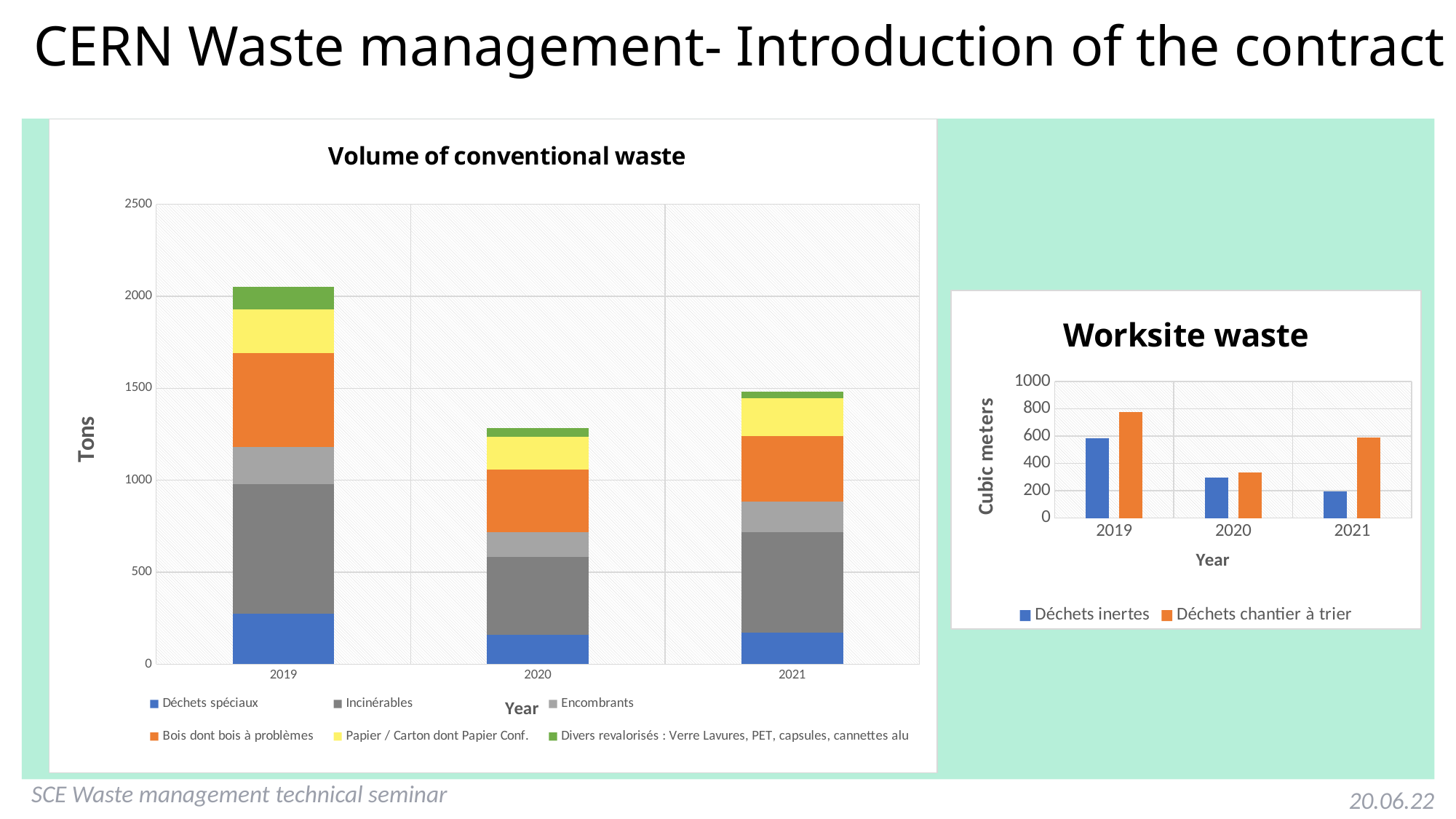
What is the y-axis label of the 'Worksite waste' chart? Cubic meters In the 'Worksite waste' chart, which year has the highest value for Déchets chantier à trier? 2019 In the 'Volume of conventional waste' chart, is the total for 2020 greater or less than 1500 tons? less How many series does the legend of the 'Volume of conventional waste' chart list? 6 In the 'Worksite waste' chart, does the value for Déchets inertes rise or fall from 2019 to 2021? fall In the 'Volume of conventional waste' chart, is the total for 2021 greater or less than 1000 tons? greater How many series does the legend of the 'Worksite waste' chart list? 2 In the 'Volume of conventional waste' chart, which year has the lowest total volume? 2020 In the 'Volume of conventional waste' chart, which series forms the largest segment of the 2019 bar? Incinérables In the 'Worksite waste' chart, is the value for Déchets chantier à trier in 2019 greater or less than 600? greater In the 'Volume of conventional waste' chart, which year has the highest total volume? 2019 What type of chart is the 'Volume of conventional waste' chart? Stacked bar chart